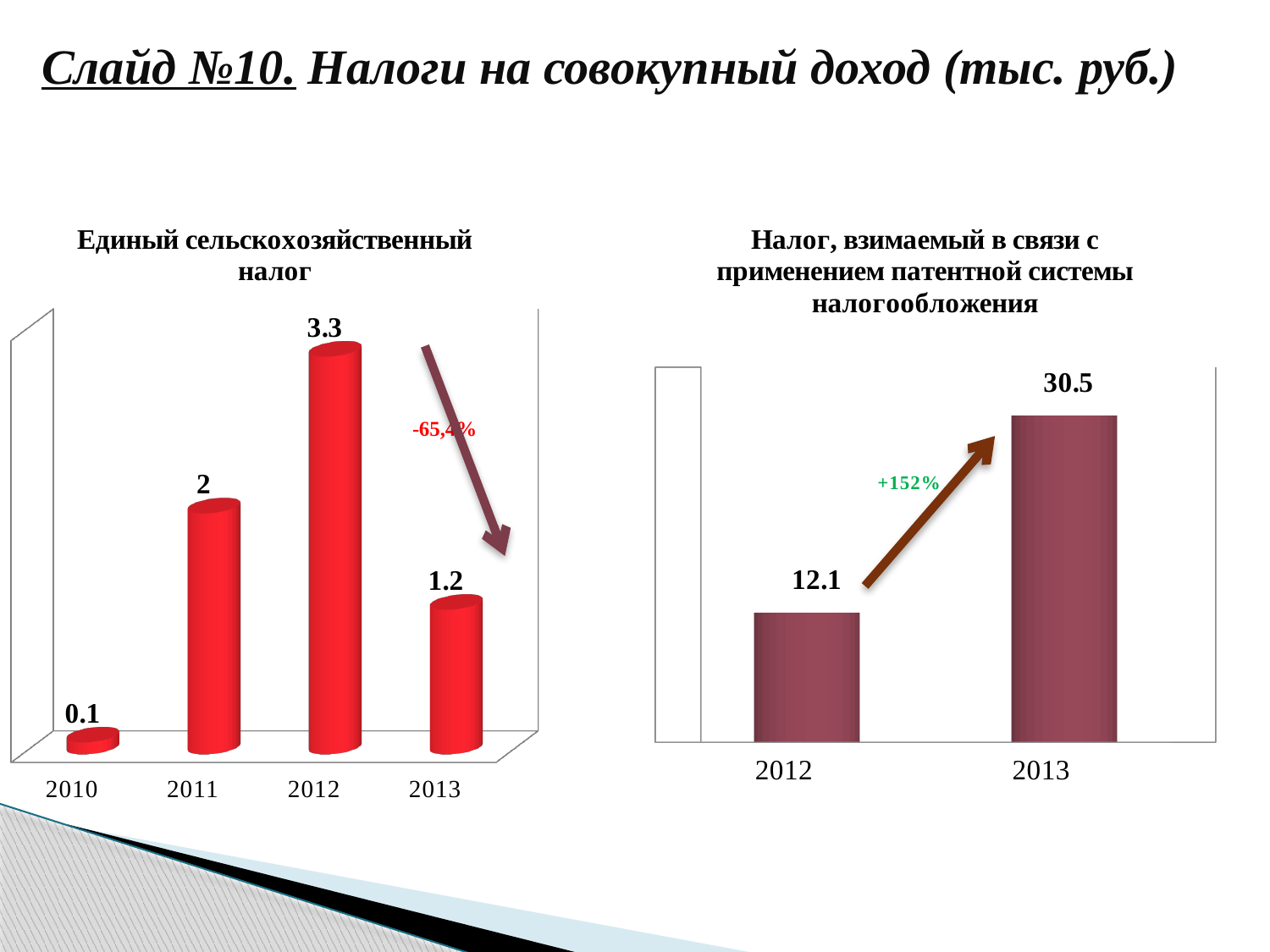
In the right chart (Налог, взимаемый в связи с применением патентной системы налогообложения), do the values rise or fall from 2012 to 2013? rise In the left chart (Единый сельскохозяйственный налог), what is the value for 2010? 0.1 In the left chart (Единый сельскохозяйственный налог), which year has the highest value? 2012 In the left chart (Единый сельскохозяйственный налог), what is the difference between the values for 2012 and 2013? 2.1 In the left chart (Единый сельскохозяйственный налог), how many years are shown on the x axis? 4 What kind of chart is the right chart (Налог, взимаемый в связи с применением патентной системы налогообложения)? bar chart In the left chart (Единый сельскохозяйственный налог), is the value for 2011 larger or smaller than the value for 2013? larger In the right chart (Налог, взимаемый в связи с применением патентной системы налогообложения), what is the value for 2013? 30.5 In the right chart (Налог, взимаемый в связи с применением патентной системы налогообложения), what is the difference between the 2013 and 2012 values? 18.4 In the left chart (Единый сельскохозяйственный налог), what is the value for 2012? 3.3 In the right chart (Налог, взимаемый в связи с применением патентной системы налогообложения), what is the value for 2012? 12.1 In the left chart (Единый сельскохозяйственный налог), which year has the lowest value? 2010